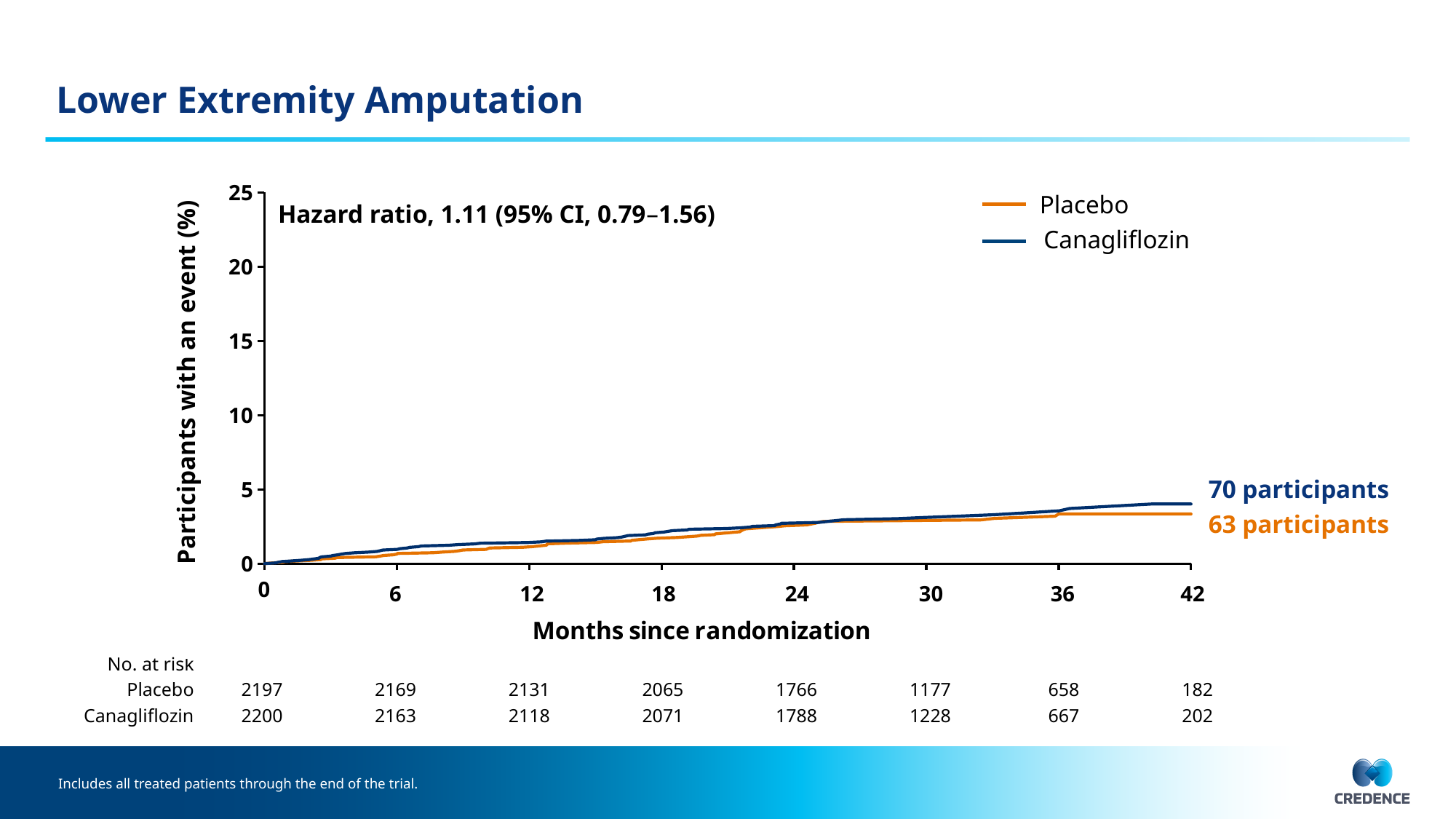
What is the 95% confidence interval for the hazard ratio shown on the chart? 0.79–1.56 How many series does the legend list? 2 What is the number at risk for the Placebo group at 24 months? 1766 What is the difference between the number of participants with an event in the Canagliflozin group and the Placebo group? 7 How many participants had an event in the Canagliflozin group? 70 participants How many participants had an event in the Placebo group? 63 participants Do the curves rise or fall as months since randomization increase? Rise Which group had more participants with an event, Placebo or Canagliflozin? Canagliflozin What kind of chart is shown on the slide? Line chart Which two groups are listed in the chart legend? Placebo and Canagliflozin What hazard ratio is shown on the chart? 1.11 Is the Canagliflozin curve at 42 months greater or less than 5%? less